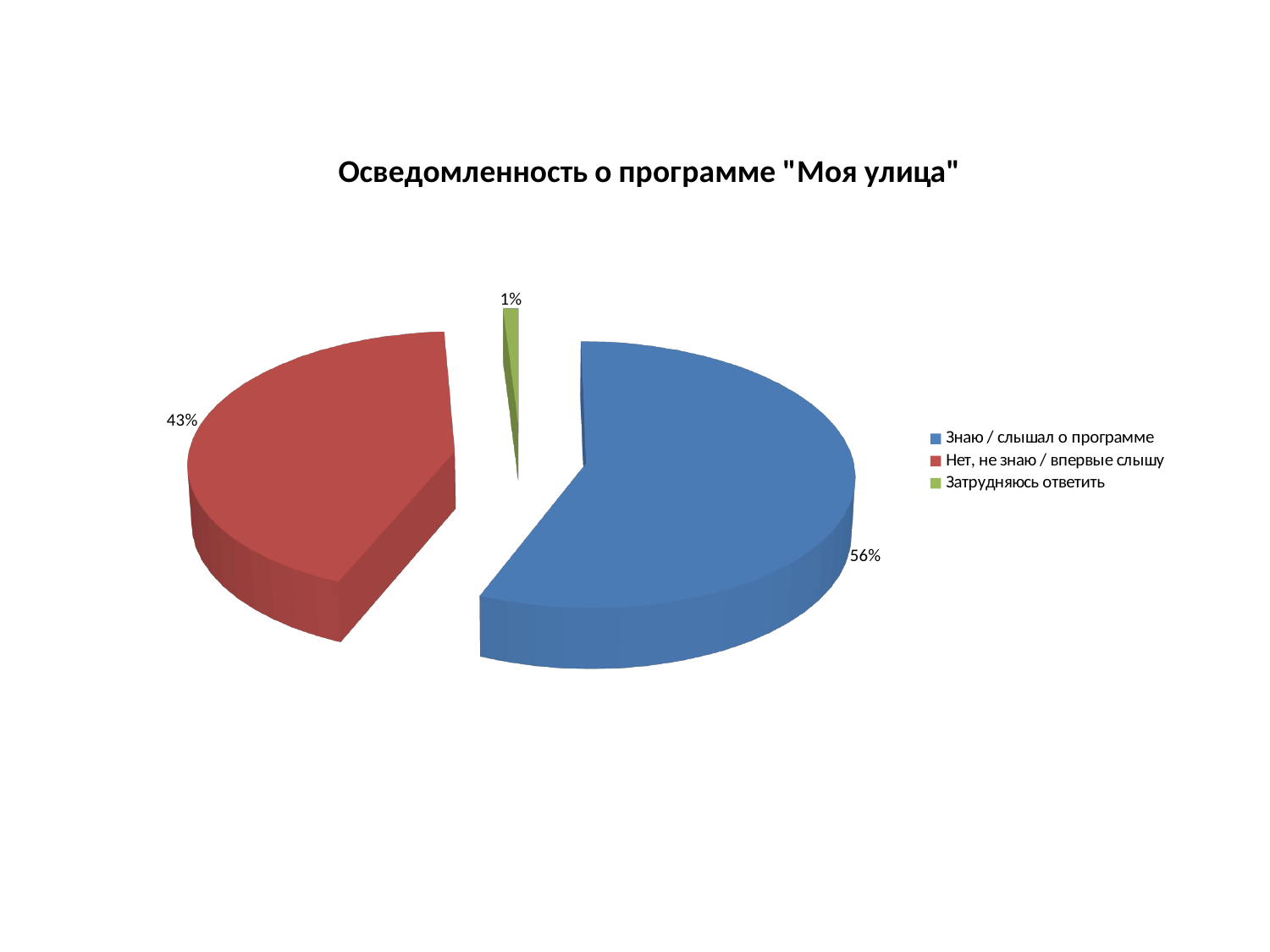
What share of the pie is labelled "Затрудняюсь ответить"? 1% How many entries does the legend list? 3 What is the title of the chart? Осведомленность о программе "Моя улица" How many slices does the pie chart have? 3 What kind of chart is shown on the slide? Pie chart Which category has the smallest slice of the pie? Затрудняюсь ответить What is the difference in percentage points between "Знаю / слышал о программе" and "Нет, не знаю / впервые слышу"? 13 What share of the pie is labelled "Нет, не знаю / впервые слышу"? 43% What share of the pie is labelled "Знаю / слышал о программе"? 56% Which is larger: the slice for "Нет, не знаю / впервые слышу" or the slice for "Затрудняюсь ответить"? Нет, не знаю / впервые слышу What colour is the slice for "Затрудняюсь ответить"? Green Which category has the largest slice of the pie? Знаю / слышал о программе